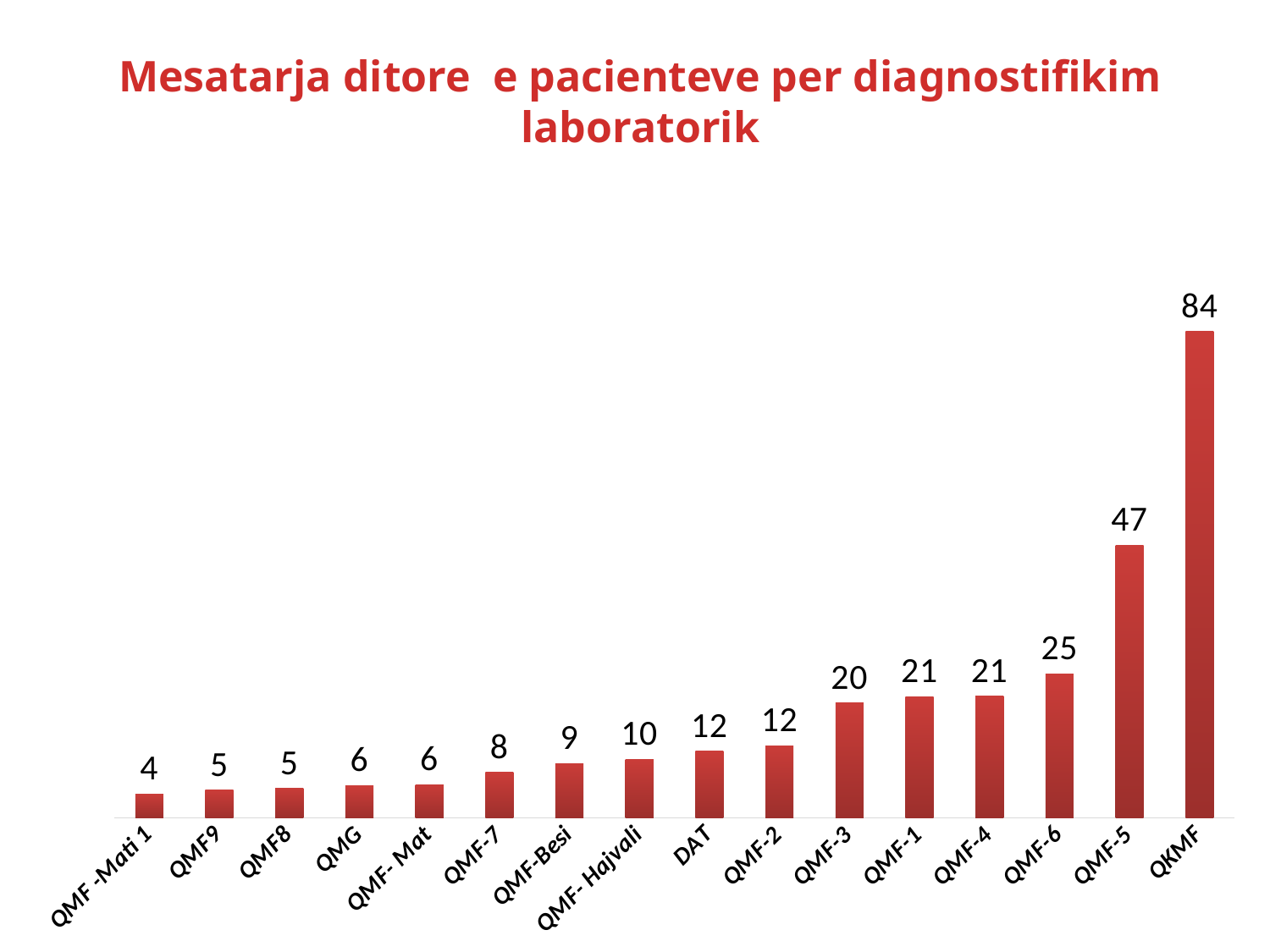
Which is larger, the value for QMF-7 or the value for QMF-Besi? QMF-Besi What is the value for QKMF? 84 What is the title of the chart? Mesatarja ditore e pacienteve per diagnostifikim laboratorik Which category has the highest value? QKMF Which category has the lowest value? QMF -Mati 1 What kind of chart is shown on the slide? Bar chart What is the difference between the values for QKMF and QMF-5? 37 What is the value for DAT? 12 What is the value for QMF-5? 47 How many categories are shown on the chart? 16 What is the value for QMF- Hajvali? 10 What is the difference between the values for QMF-6 and QMF-3? 5